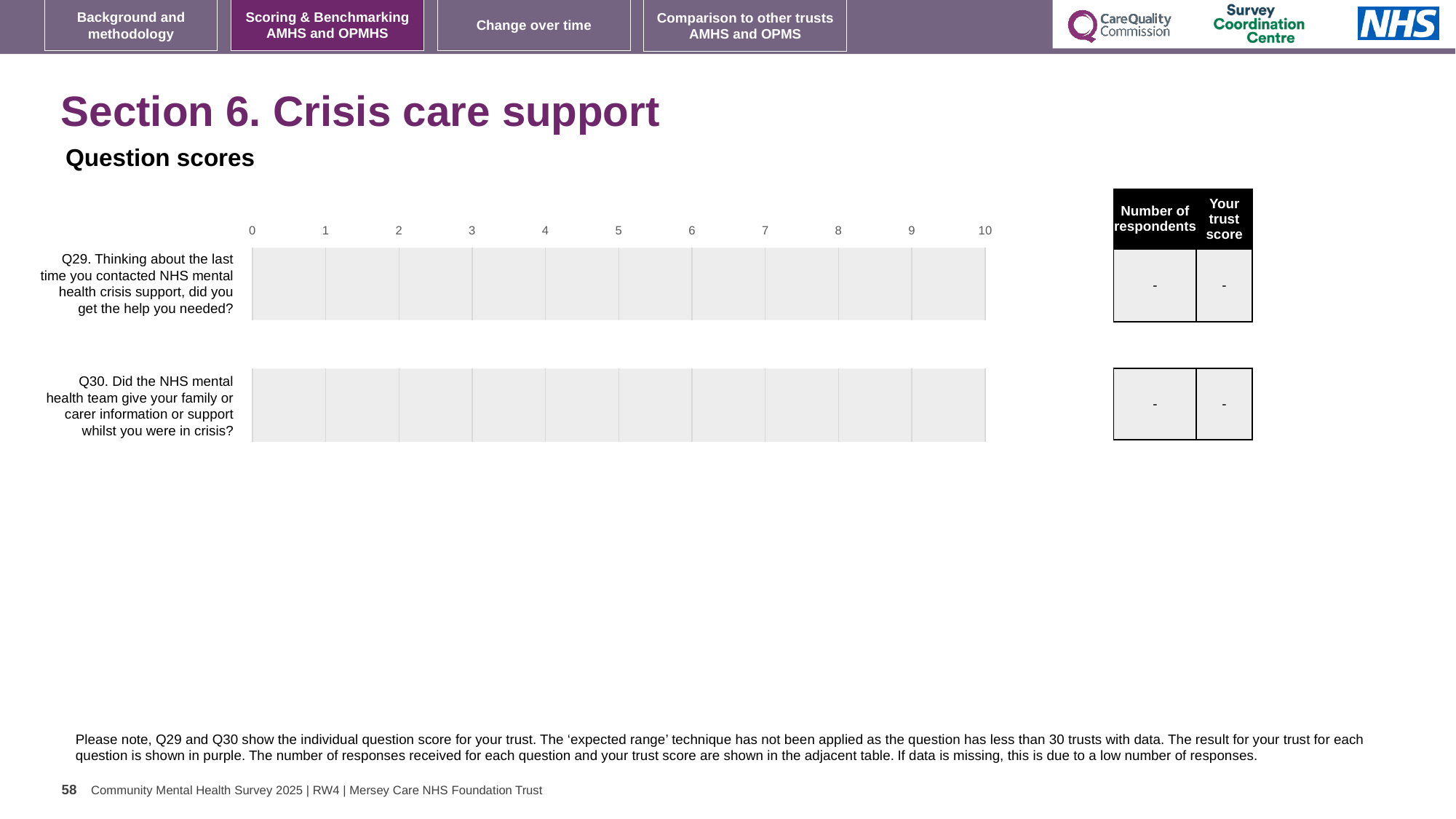
What is the lowest value shown on the chart's horizontal axis? 0 What is the highest value shown on the chart's horizontal axis? 10 What is the 'Your trust score' shown in the table for Q30? - What is the 'Number of respondents' shown in the table for Q29? - How many questions are listed as categories on the chart? 2 Which question label appears first (at the top) on the chart? Q29 What is the 'Your trust score' shown in the table for Q29? - What is the 'Number of respondents' shown in the table for Q30? -